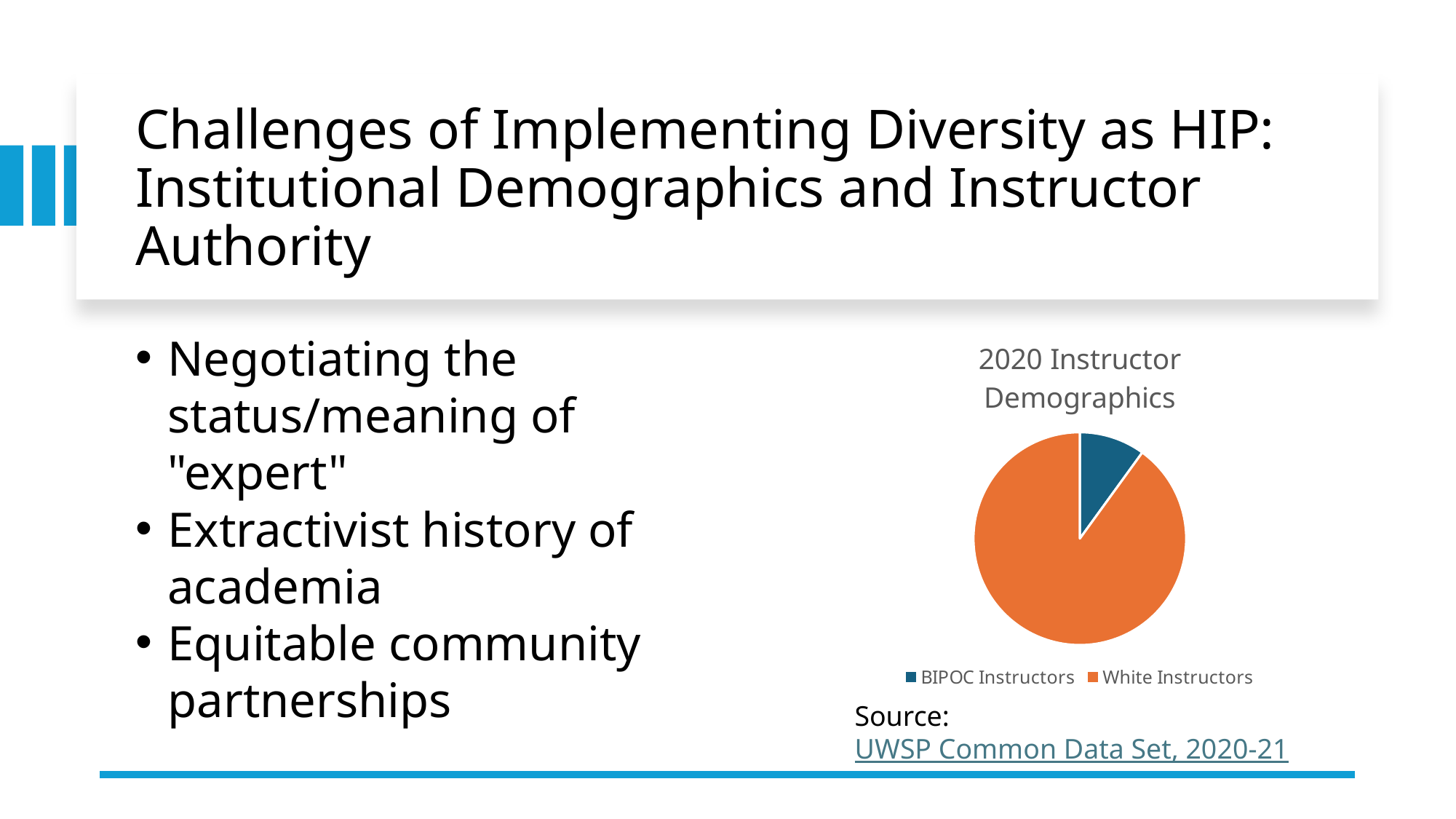
Which slice is larger in the pie chart, BIPOC Instructors or White Instructors? White Instructors How many categories does the legend of the pie chart list? 2 Which category has the largest slice in the pie chart? White Instructors What is the title of the pie chart? 2020 Instructor Demographics How many slices does the pie chart have? 2 What colour represents White Instructors in the pie chart? Orange Which category has the smallest slice in the pie chart? BIPOC Instructors What kind of chart is shown on the slide? Pie chart